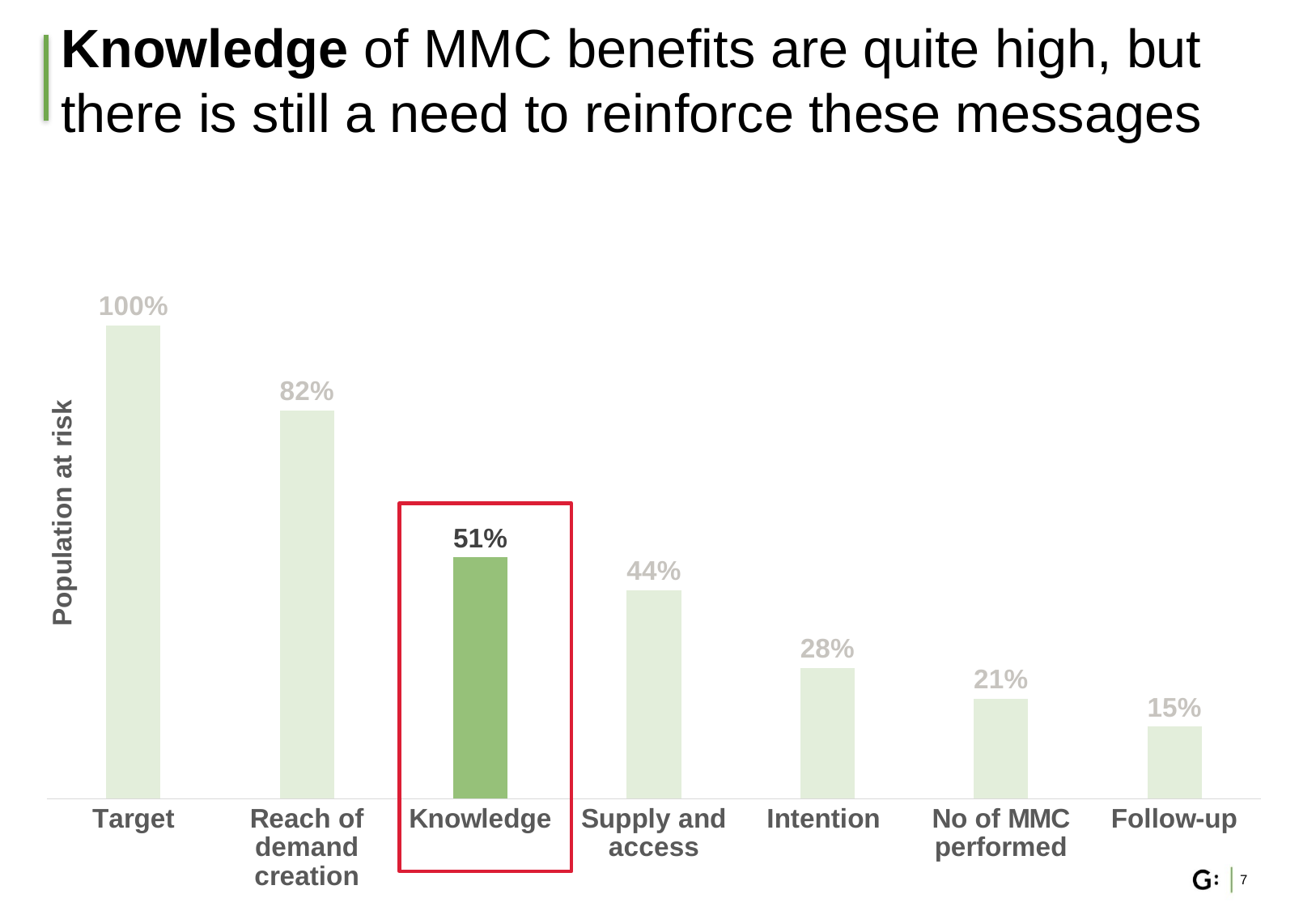
Which category has the highest value? Target What is the label of the y axis? Population at risk What kind of chart is shown on the slide? Bar chart What is the value for No of MMC performed? 21% What is the value for Supply and access? 44% Do the values rise or fall from left to right along the x axis? Fall What is the value for Knowledge? 51% Which category has the lowest value? Follow-up What is the difference between the values for Intention and Follow-up? 13% How many categories are shown on the x axis? 7 Which is larger, the value for Supply and access or the value for Intention? Supply and access What is the difference between the values for Reach of demand creation and Knowledge? 31%